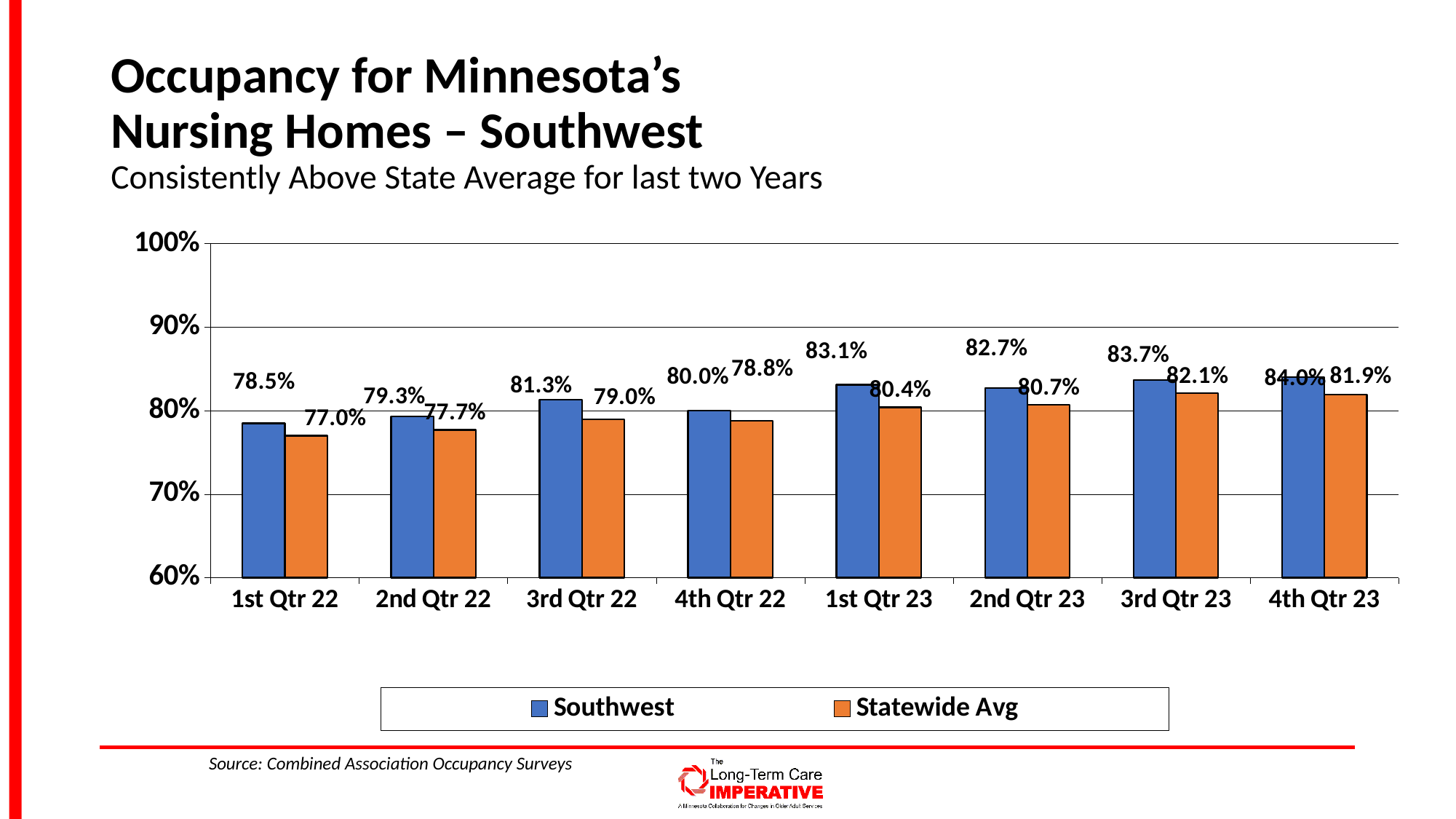
What is the Southwest occupancy value for 1st Qtr 22? 78.5% In which quarter is the Southwest occupancy highest? 4th Qtr 23 How many quarters are shown on the x axis? 8 Does the Statewide Avg occupancy generally rise or fall from 1st Qtr 22 to 4th Qtr 23? Rise In which quarter is the Statewide Avg occupancy lowest? 1st Qtr 22 What is the difference between the Southwest and Statewide Avg values in 1st Qtr 23? 2.7% How many series does the legend list? 2 What is the Statewide Avg occupancy value for 3rd Qtr 23? 82.1% What kind of chart is shown on the slide? Bar chart What is the Southwest occupancy value for 4th Qtr 23? 84.0% Is the Statewide Avg value for 4th Qtr 22 greater or less than 80%? less Which is larger in 2nd Qtr 22, the Southwest value or the Statewide Avg value? Southwest